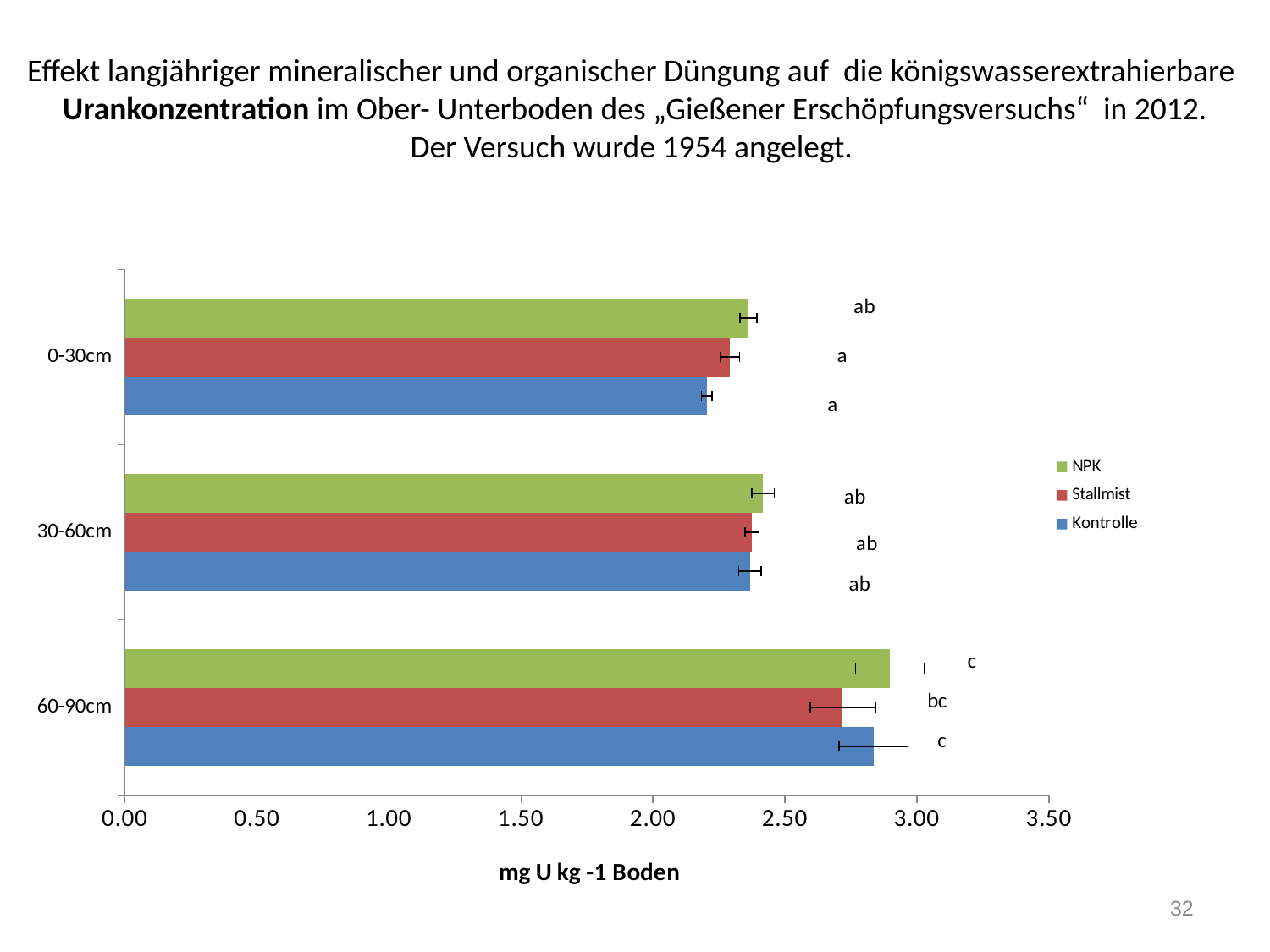
What kind of chart is shown on the slide? bar chart Is the Kontrolle value for 0-30cm greater or less than 2.50? less Is the NPK value for 60-90cm greater or less than 2.50? greater Which series has the lowest value in the 60-90cm category? Stallmist Which is larger: the Kontrolle value for 60-90cm or the Kontrolle value for 0-30cm? 60-90cm How many depth categories are shown on the vertical axis? 3 In which depth category does NPK have its highest value? 60-90cm Is the Stallmist value for 60-90cm greater or less than 2.50? greater Which series has the lowest value in the 0-30cm category? Kontrolle How many series does the legend list? 3 Which series has the highest value in the 0-30cm category? NPK What is the label of the horizontal axis? mg U kg -1 Boden